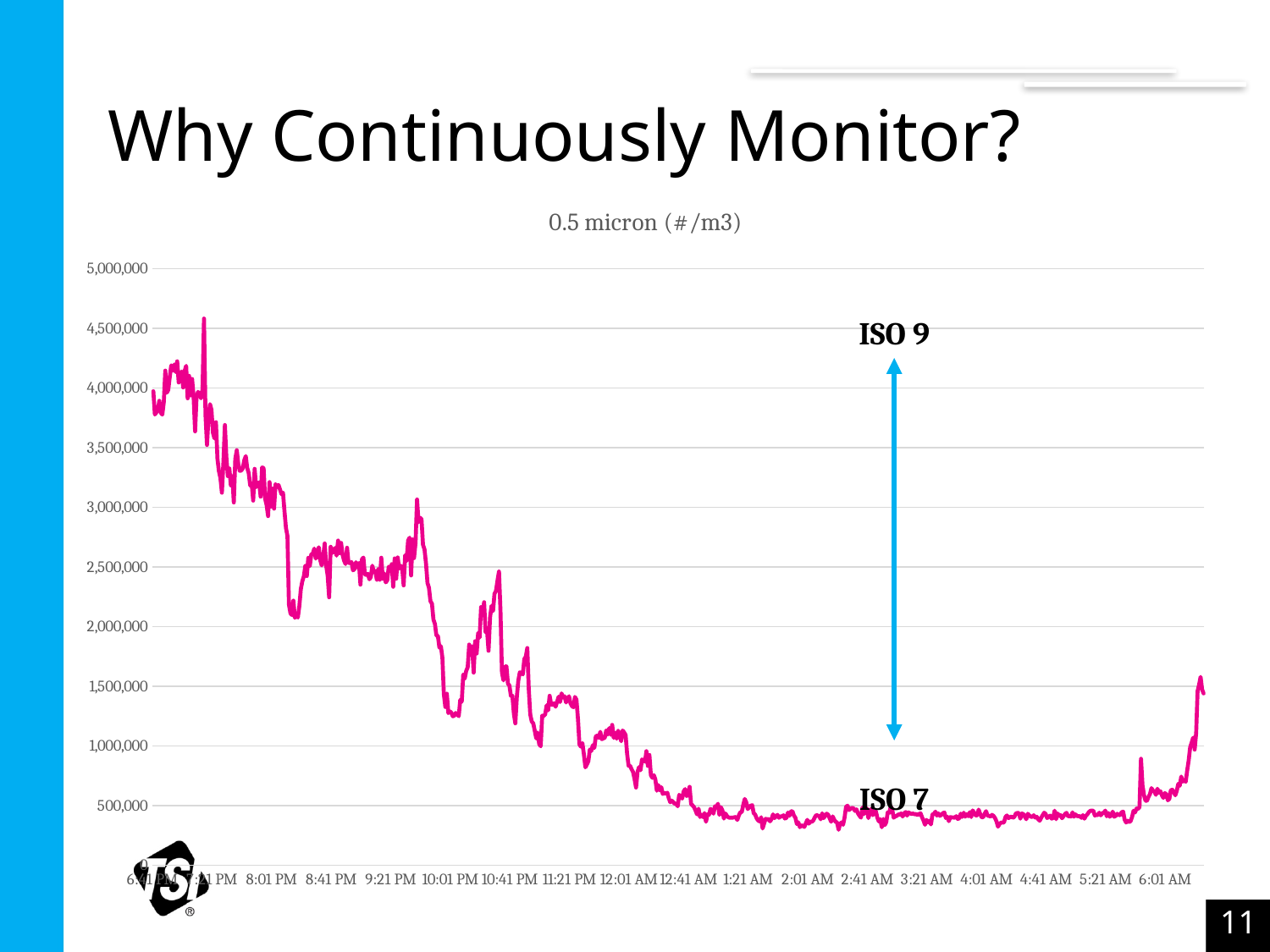
Is the value at 10:01 PM greater or less than 2,500,000? less Is the value at 7:21 PM greater or less than 3,000,000? greater Is the value at 6:01 AM greater or less than 1,000,000? greater What is the last time label on the x axis? 6:01 AM What kind of chart is shown on the slide? line chart What is the highest value shown on the y axis? 5,000,000 How many lines are plotted on the chart? 1 What is the title of the chart? 0.5 micron (#/m3) Overall, do the values rise or fall from 6:41 PM to 2:01 AM? fall Which is larger, the value at 8:41 PM or the value at 3:21 AM? 8:41 PM